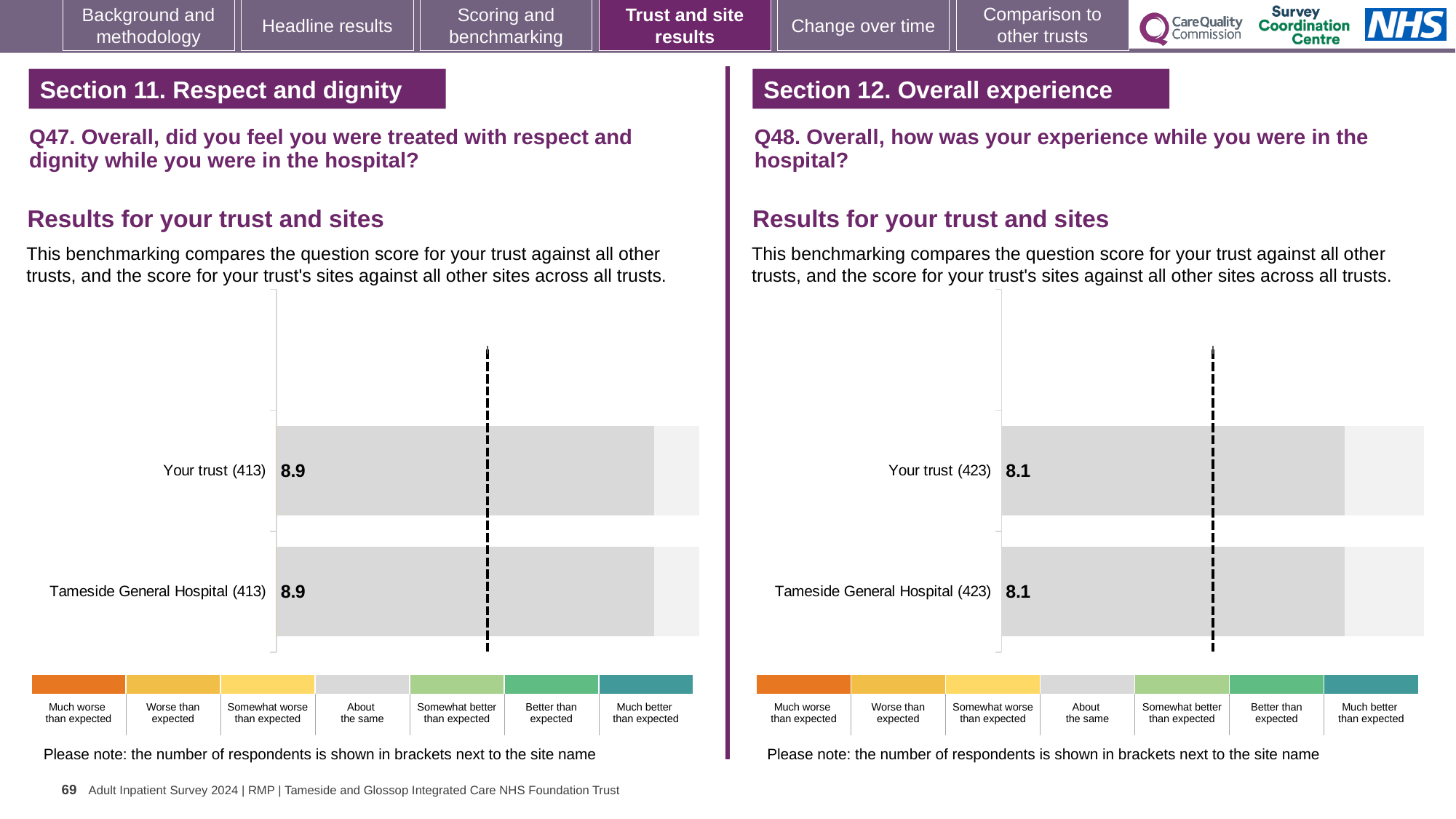
How many bars are plotted in the Q48 chart on the right? 2 In the Q48 chart on the right, what is the score for Your trust? 8.1 How many bars are plotted in the Q47 chart on the left? 2 In the Q48 chart on the right, how many respondents are shown in brackets next to Tameside General Hospital? 423 In the Q47 chart on the left, what is the score for Tameside General Hospital? 8.9 In the Q47 chart on the left, what is the difference between the score for Your trust and the score for Tameside General Hospital? 0 In the Q48 chart on the right, what is the difference between the score for Your trust and the score for Tameside General Hospital? 0 In the Q47 chart on the left, how many respondents are shown in brackets next to Your trust? 413 In the Q48 chart on the right, what is the score for Tameside General Hospital? 8.1 What kind of chart is used for the Q47 results on the left? Bar chart In the Q47 chart on the left, what is the score for Your trust? 8.9